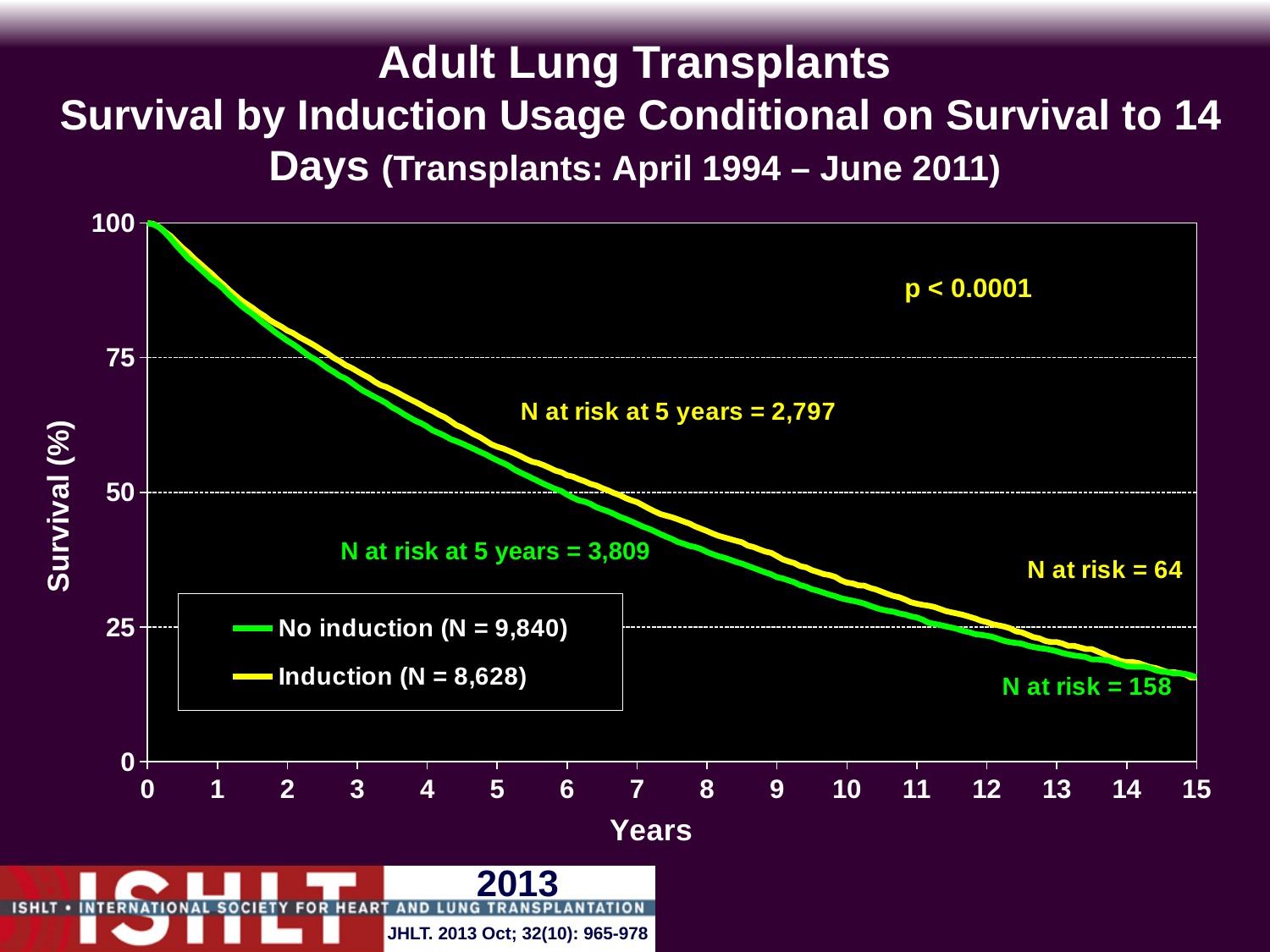
What is the label of the y axis? Survival (%) What kind of chart is shown on the slide? Line chart What is the N for the No induction group shown in the legend? 9,840 What is the N at risk at 5 years for the Induction group (yellow label)? 2,797 What is the N for the Induction group shown in the legend? 8,628 Is the survival value for the No induction curve at 10 years greater or less than 50? less Do the survival curves rise or fall as years increase? Fall At 10 years, which series shows higher survival, Induction or No induction? Induction What p-value is printed on the chart? p < 0.0001 What is the N at risk at 5 years for the No induction group (green label)? 3,809 Is the survival value for the Induction curve at 5 years greater or less than 50? greater How many series does the legend list? 2